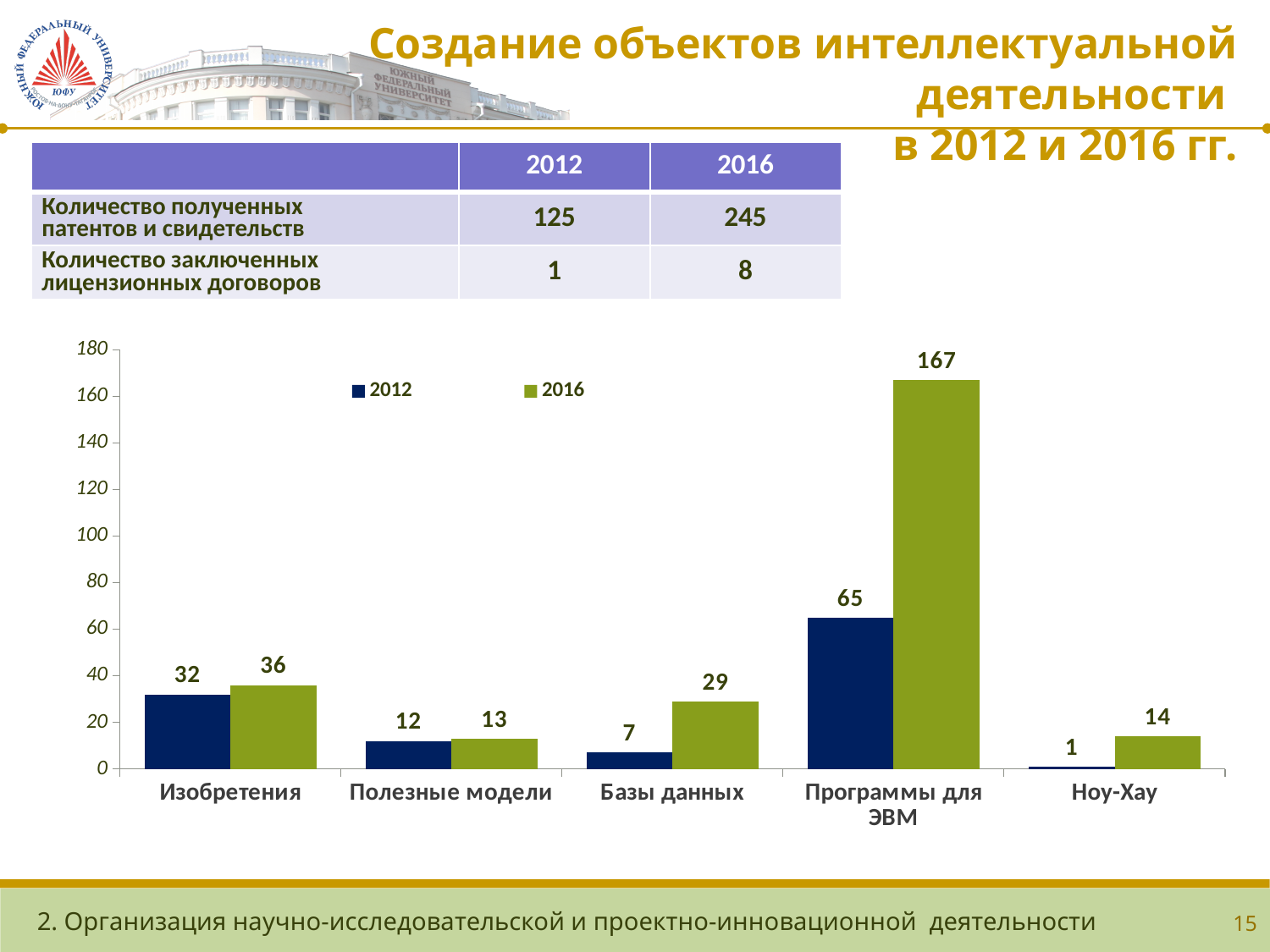
How many series does the chart legend list? 2 Which category has the lowest 2016 value? Полезные модели Which is larger: the 2016 value for Изобретения or the 2016 value for Базы данных? Изобретения How many categories are shown on the x axis of the chart? 5 What is the difference between the 2016 and 2012 values for Программы для ЭВМ? 102 Is the 2012 value for Программы для ЭВМ greater or less than 60? greater What is the difference between the 2016 and 2012 values for Базы данных? 22 Which category has the highest 2012 value? Программы для ЭВМ What is the 2012 value for Базы данных? 7 What is the 2016 value for Ноу-Хау? 14 What kind of chart is shown on the slide? bar chart What is the 2016 value for Программы для ЭВМ? 167